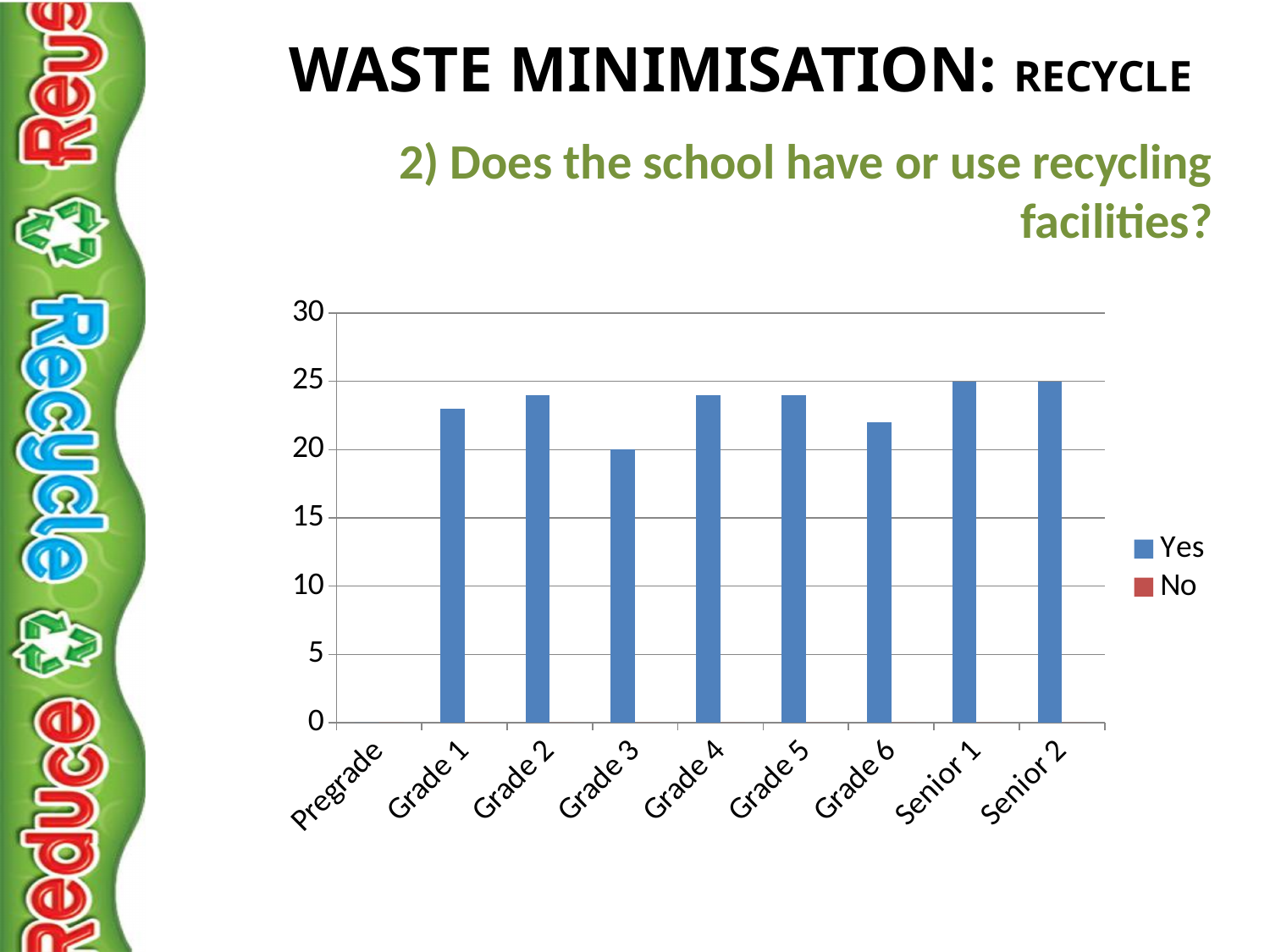
What is the Yes value for Senior 2? 25 How many categories are shown on the x axis of the chart? 9 Is the Yes value for Grade 1 greater or less than 20? greater How many series does the chart's legend list? 2 Is the Yes value for Grade 6 greater or less than 25? less Which has the larger Yes value, Grade 3 or Grade 4? Grade 4 Is the Yes value for Grade 2 greater or less than 20? greater Which has the larger Yes value, Grade 6 or Senior 1? Senior 1 What is the Yes value for Grade 3? 20 What is the Yes value for Senior 1? 25 Which series in the legend is shown in blue? Yes What kind of chart is shown on the slide? bar chart